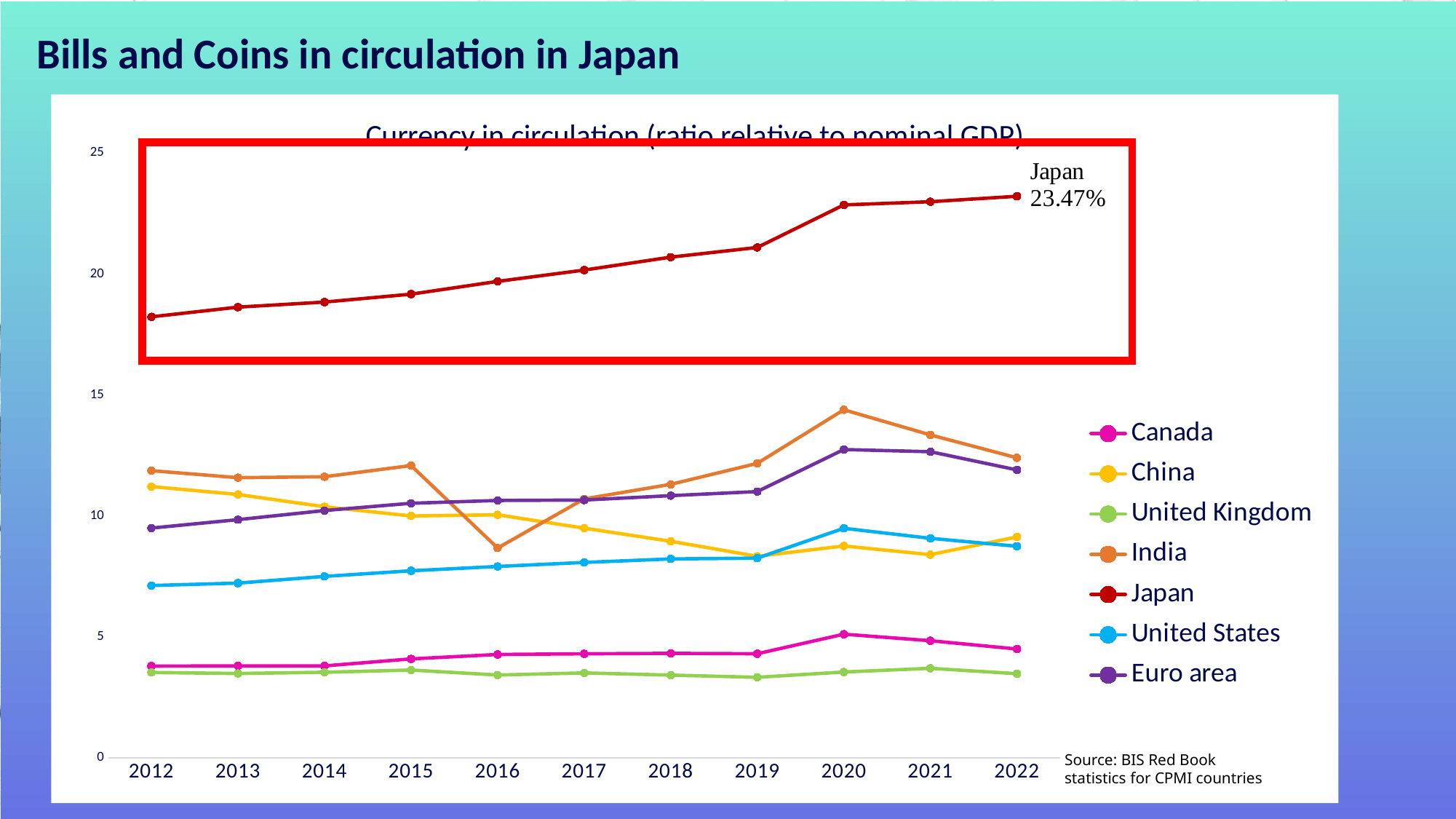
Which series has the highest value in 2022? Japan Does the value for Japan rise or fall from 2012 to 2022? rise Which series has the lowest value in 2022? United Kingdom How many years are shown on the x axis? 11 How many series does the legend list? 7 What is the value for Japan in 2022? 23.47% What source is cited for the chart data? BIS Red Book statistics for CPMI countries Is the value for Japan in 2012 greater or less than 20? less Is the value for India in 2020 greater or less than 15? less Which is larger in 2022, the value for Euro area or the value for United States? Euro area Which is larger in 2022, the value for India or the value for China? India What kind of chart is shown on the slide? line chart